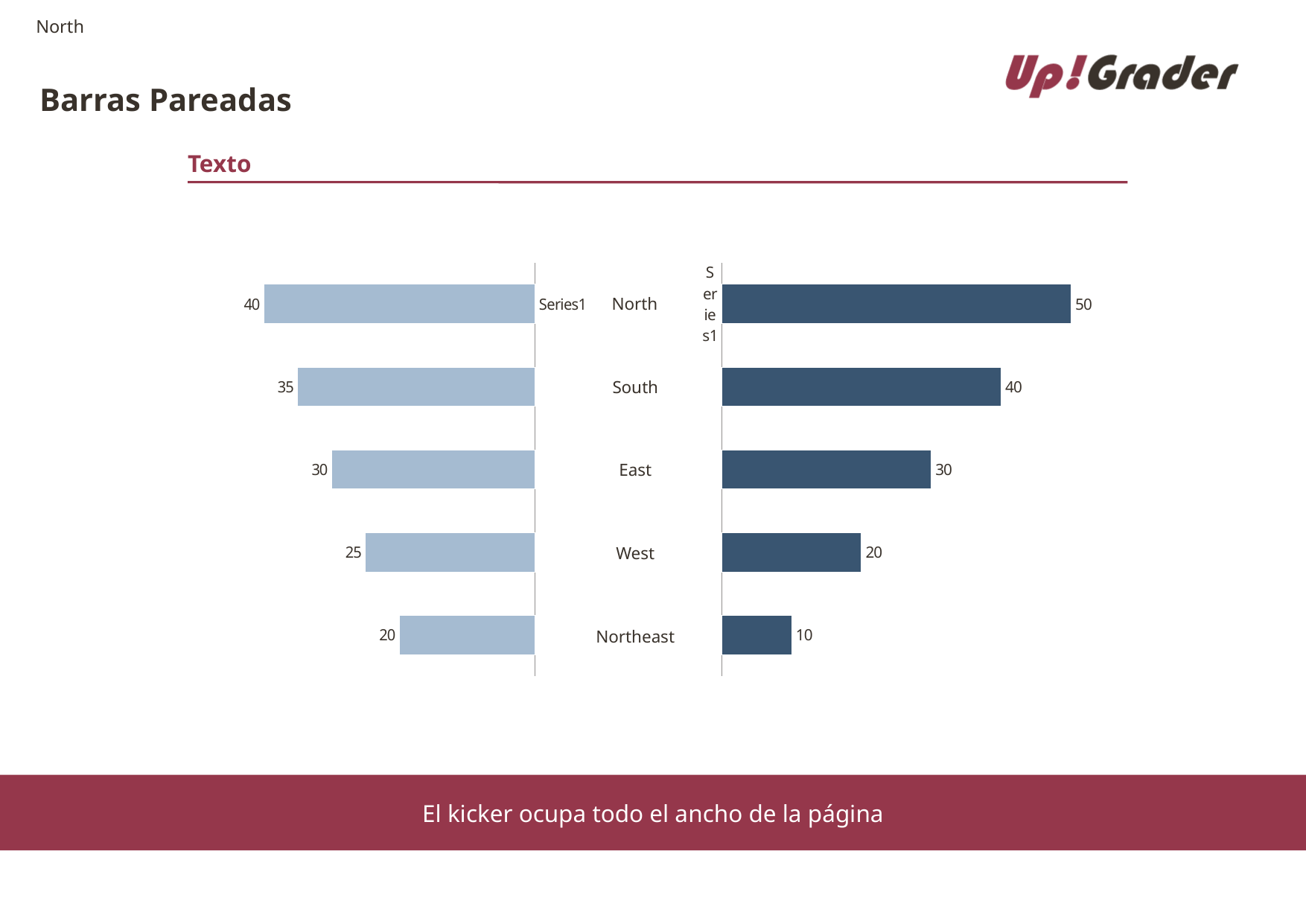
In the left chart, what is the value for North? 40 Which is larger: the value for Northeast in the left chart or in the right chart? Left chart (20) In the right chart, what is the difference between the values for North and West? 30 In the left chart, which category has the lowest value? Northeast In the left chart, what is the difference between the values for South and Northeast? 15 In the right chart, what is the value for South? 40 In the right chart, which category has the highest value? North How many categories are shown in the right chart? 5 In the right chart, what is the value for Northeast? 10 Which is larger: the value for East in the left chart or the value for East in the right chart? They are equal (30) What kind of chart is shown on the slide? Bar chart In the left chart, what is the value for West? 25